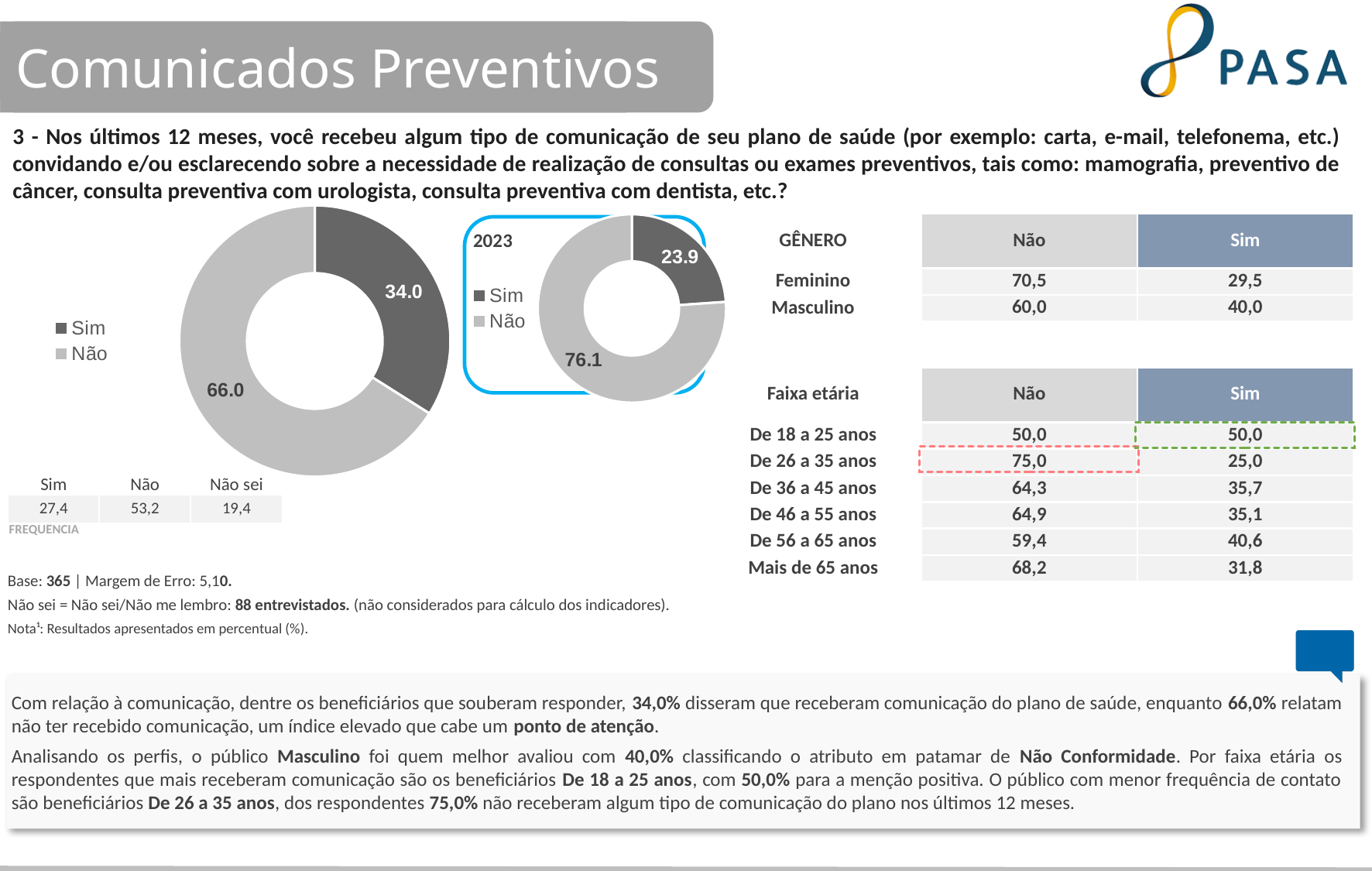
In the smaller donut chart labelled 2023, which category has the smallest share? Sim In the smaller donut chart labelled 2023, what is the value for Não? 76.1 How many categories does the large donut chart on the left show? 2 In the large donut chart on the left, what is the difference between the Não and Sim values? 32.0 In the smaller donut chart labelled 2023, what is the difference between the Não and Sim values? 52.2 In the large donut chart on the left, which category has the largest share? Não In the large donut chart on the left, what is the value for Não? 66.0 In the large donut chart on the left, what is the value for Sim? 34.0 What are the two legend entries shown for the donut charts? Sim and Não What type of chart is the large chart on the left? Donut (pie) chart In the smaller donut chart labelled 2023, what is the value for Sim? 23.9 Which is larger: the Sim value in the large donut chart on the left or the Sim value in the smaller donut chart labelled 2023? The large donut chart on the left (34.0)